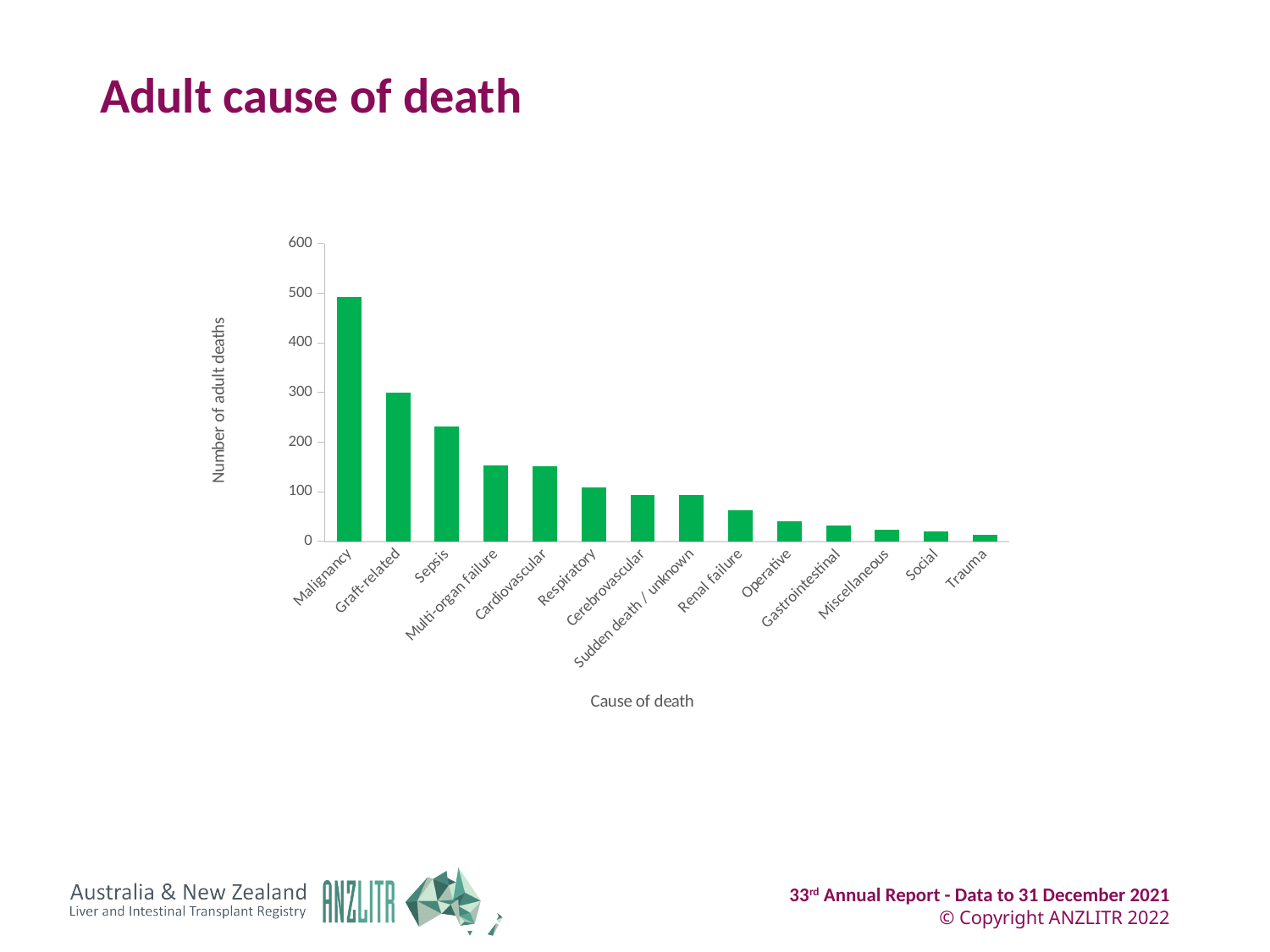
What type of chart is shown on the slide? bar chart Is the value for Sepsis greater or less than 200? greater Is the value for Renal failure greater or less than 100? less Do the values rise or fall moving from left to right along the x axis? fall Which cause of death has the lowest number of adult deaths? Trauma Is the value for Malignancy greater or less than 400? greater Which has more adult deaths, Sepsis or Respiratory? Sepsis Which has more adult deaths, Malignancy or Graft-related? Malignancy How many causes of death are shown on the x axis? 14 What is the label of the y axis? Number of adult deaths Which cause of death has the highest number of adult deaths? Malignancy